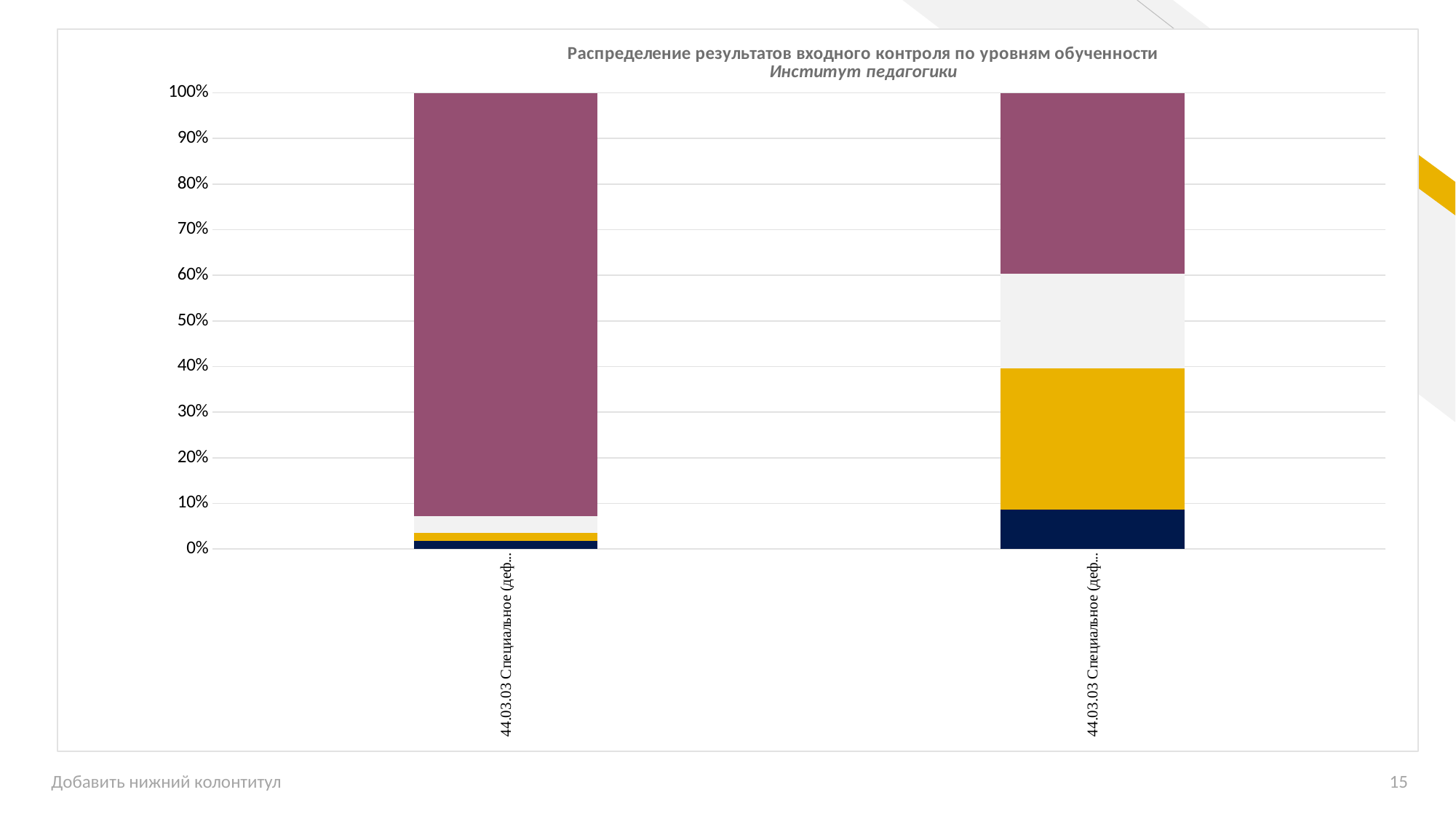
What is the total height of each stacked bar on the percentage axis? 100% What is the first line of the chart title? Распределение результатов входного контроля по уровням обученности Which bar, left or right, has the larger yellow segment? Right In the right bar, is the top of the dark navy (bottom) segment greater or less than 10%? less How many bars are plotted in the chart? 2 In the right bar, is the boundary between the grey and purple segments greater or less than 50%? greater How many coloured segments make up each stacked bar? 4 In the left bar, is the share of the purple (top) segment greater or less than 90%? greater Which bar, left or right, has the larger purple segment? Left What kind of chart is shown on the slide? Stacked bar chart What institute is named in the chart subtitle? Институт педагогики